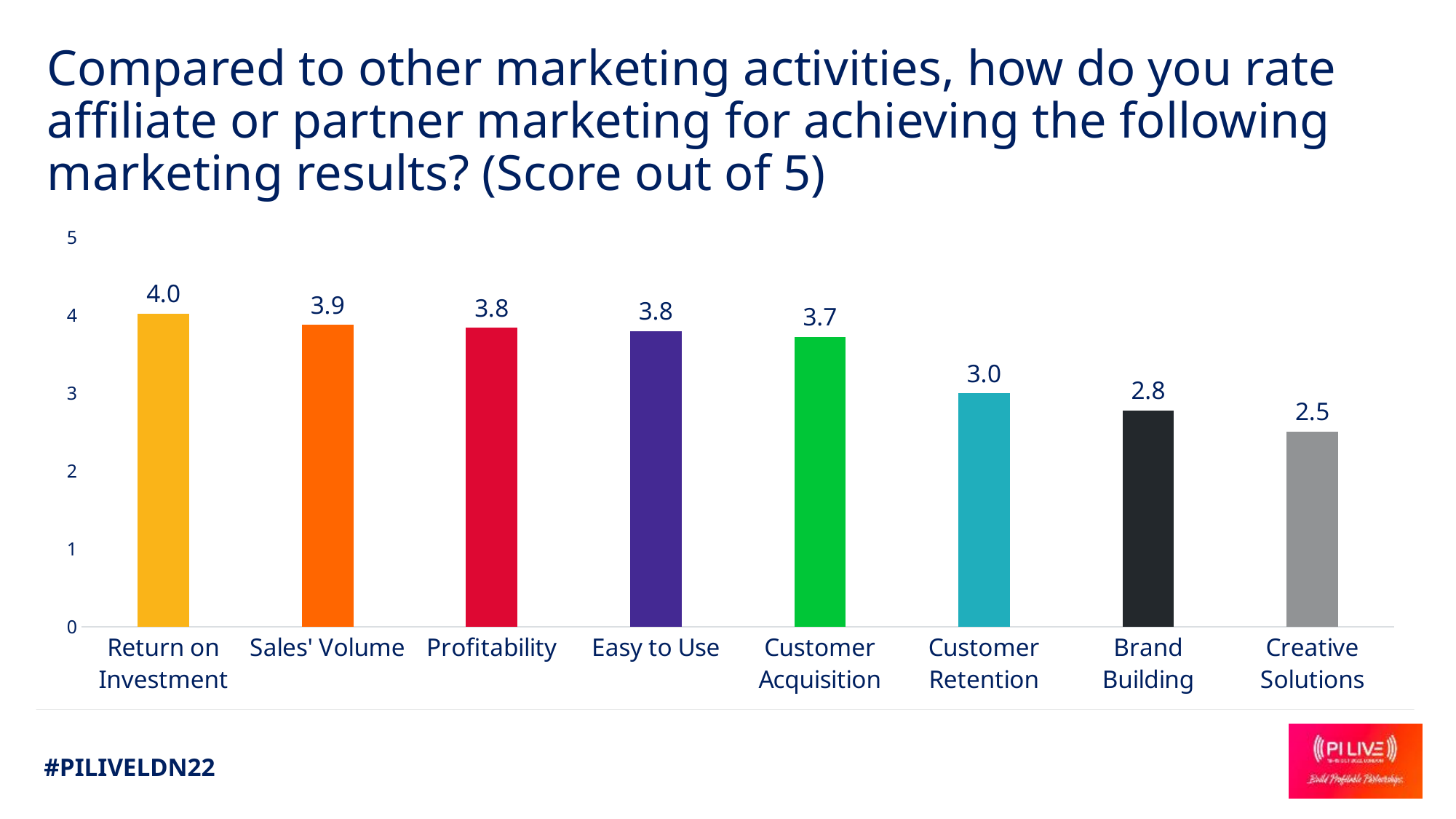
What is the score for Brand Building? 2.8 What is the score for Return on Investment? 4.0 Which category has the highest score? Return on Investment What kind of chart is shown on the slide? Bar chart How many categories are shown in the chart? 8 Is the score for Creative Solutions greater or less than 3? less Which has a higher score, Sales' Volume or Brand Building? Sales' Volume What is the difference between the scores for Return on Investment and Creative Solutions? 1.5 What is the score for Customer Retention? 3.0 Do the scores rise or fall from left to right across the categories? Fall What is the difference between the scores for Customer Acquisition and Customer Retention? 0.7 Which category has the lowest score? Creative Solutions